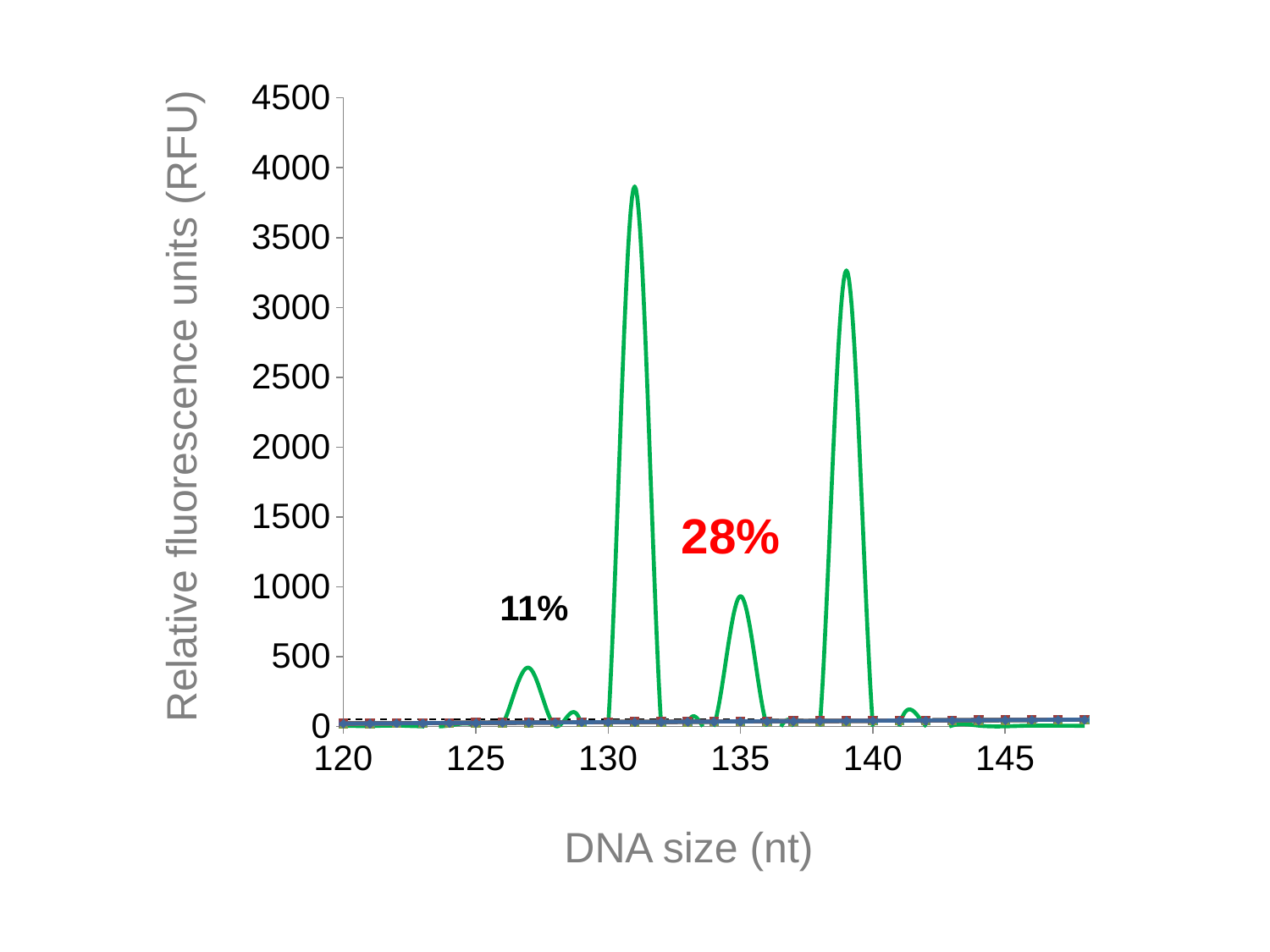
Is the value of the peak near 135 nt greater or less than 1000? less Which peak is taller, the one near 131 nt or the one near 139 nt? the one near 131 nt What percentage label is printed in red on the chart? 28% Is the value of the peak near 135 nt greater or less than 500? greater Is the value of the peak near 127 nt greater or less than 500? less What is the title of the y axis? Relative fluorescence units (RFU) What kind of chart is shown on the slide? line chart Which peak is taller, the one near 127 nt or the one near 135 nt? the one near 135 nt